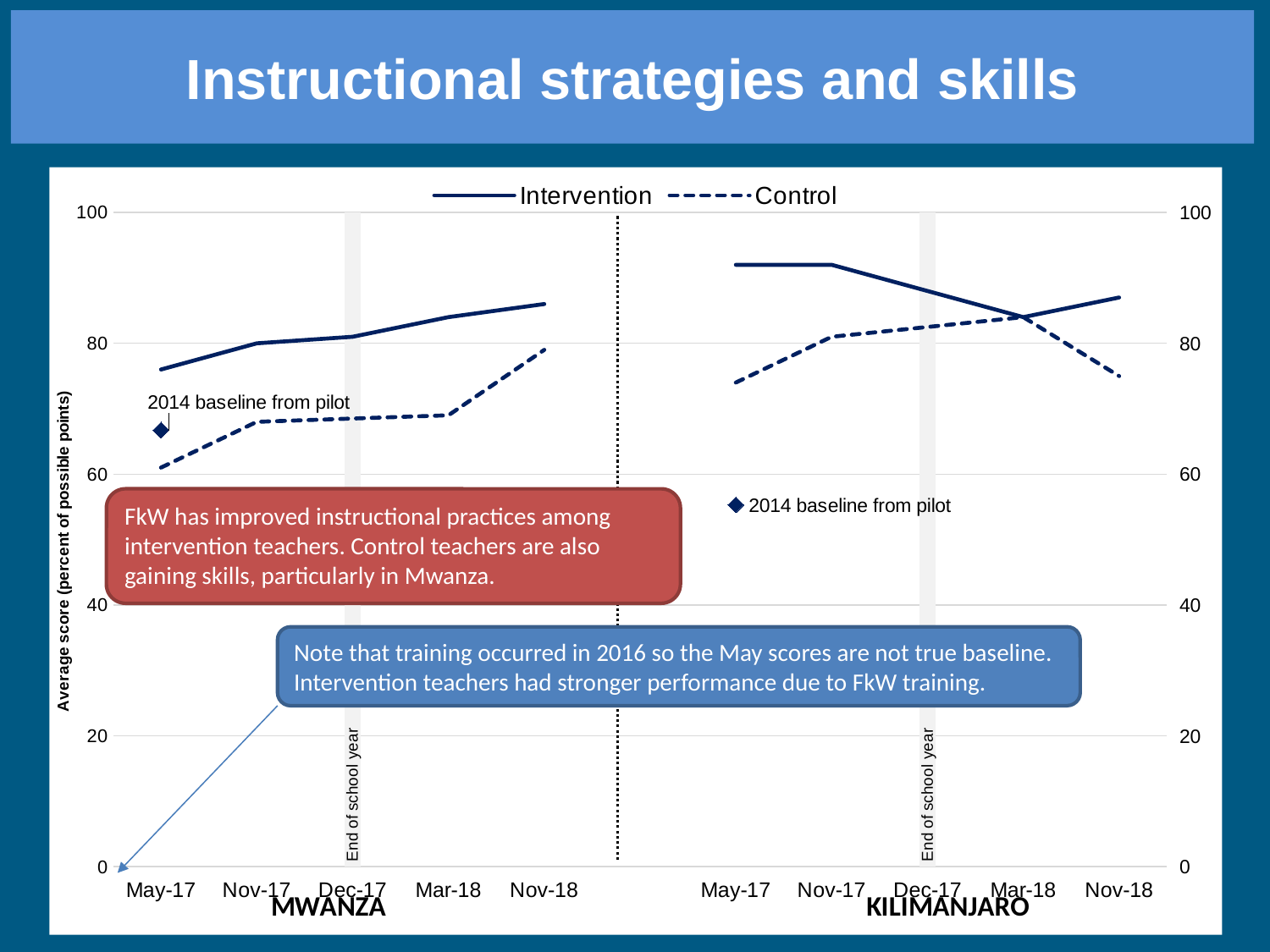
How many series does the legend at the top of the chart list? 2 In the Mwanza panel, is the Intervention value at Nov-18 greater or less than 80? greater In the Mwanza panel, does the Intervention line rise or fall from May-17 to Nov-18? rise In the Kilimanjaro panel, is the Intervention value at May-17 greater or less than 80? greater In the Mwanza panel, is the Intervention value at May-17 greater or less than 80? less What is the title of the vertical axis? Average score (percent of possible points) In the Kilimanjaro panel, does the Intervention line rise or fall from Nov-17 to Mar-18? fall What kind of chart is shown on the slide? line chart Which series is drawn with a dashed line? Control How many time points are labelled on the x axis for the Mwanza panel? 5 In the Mwanza panel at May-17, which series has the higher value, Intervention or Control? Intervention